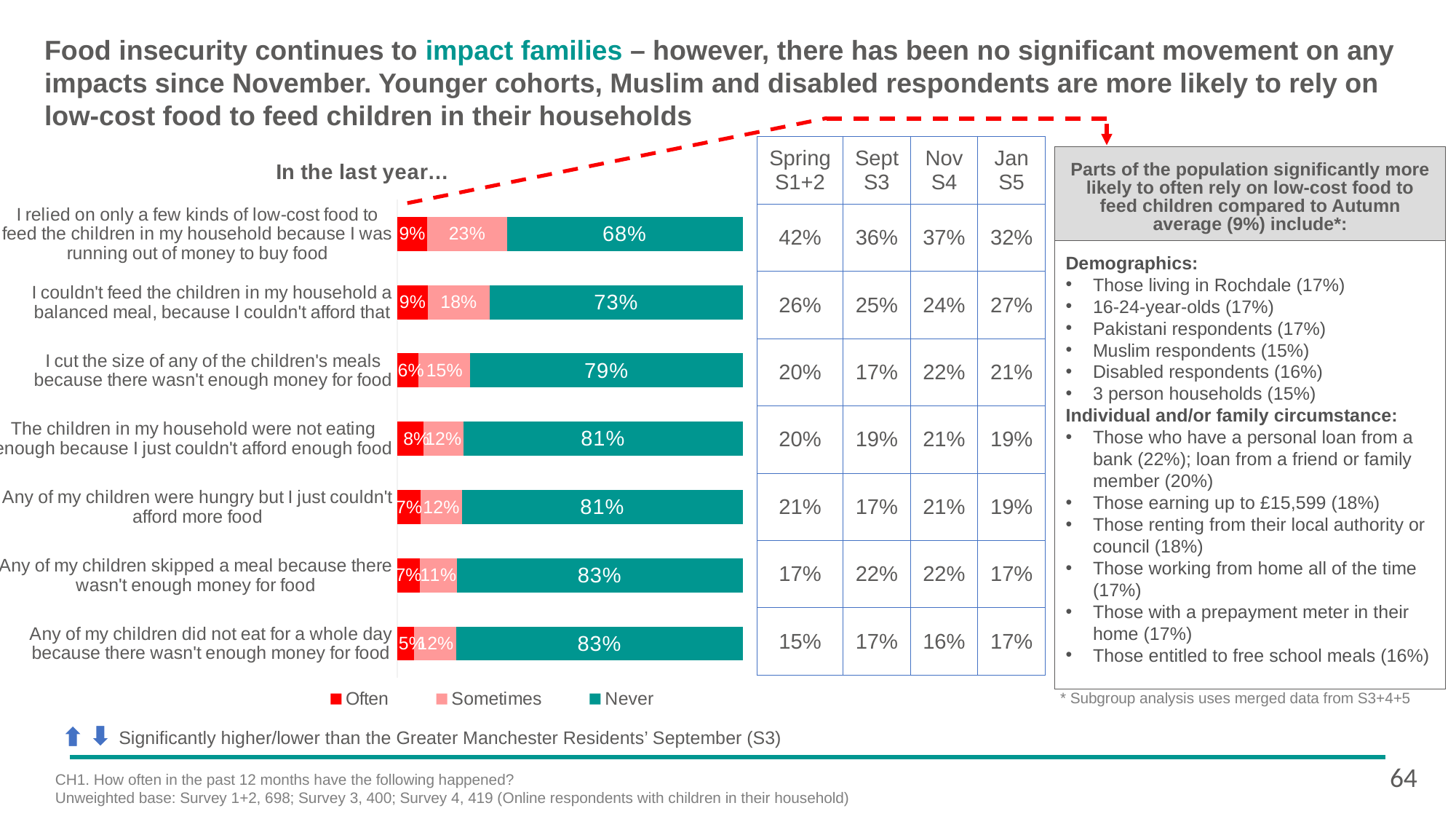
What kind of chart is shown on the slide? Stacked bar chart What percentage of respondents said they 'Never' relied on only a few kinds of low-cost food to feed the children in their household? 68% What is the 'Sometimes' value for 'I couldn't feed the children in my household a balanced meal, because I couldn't afford that'? 18% What is the 'Often' value for 'Any of my children did not eat for a whole day because there wasn't enough money for food'? 5% What is the total of the stacked bar for 'I relied on only a few kinds of low-cost food to feed the children in my household'? 100% What is the difference between the 'Never' values for 'I cut the size of any of the children's meals' and 'I relied on only a few kinds of low-cost food'? 11% Which legend entry is shown in teal/green? Never How many series does the chart legend list? 3 Which statement has the lowest 'Often' value? Any of my children did not eat for a whole day because there wasn't enough money for food How many statements (categories) are plotted in the bar chart? 7 Which statement has the highest 'Sometimes' value? I relied on only a few kinds of low-cost food to feed the children in my household because I was running out of money to buy food Which is larger: the 'Sometimes' value for 'I cut the size of any of the children's meals' or for 'Any of my children skipped a meal'? I cut the size of any of the children's meals